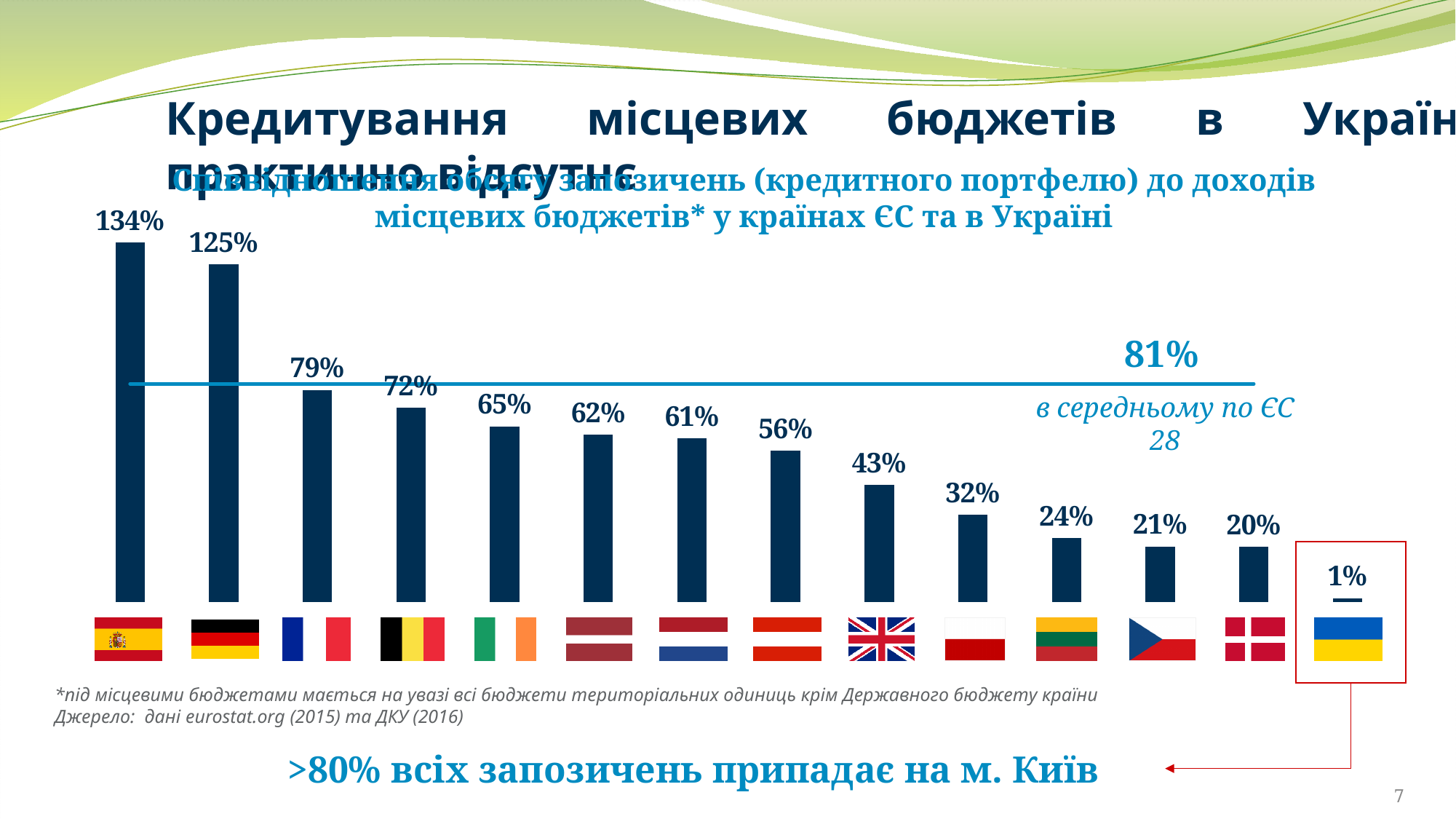
What is the value of the bar marked with the German flag (second from the left)? 125% Which bar has the highest value in the chart? Spain (first bar, 134%) What is the difference between the first bar (134%) and the second bar (125%)? 9% Do the bar values rise or fall from left to right across the chart? fall How many bars (countries) are plotted in the chart? 14 Which is larger: the bar with the French flag or the bar with the Belgian flag? the bar with the French flag (79%) What is the value of the bar marked with the UK flag? 43% What is the value of the bar marked with the Ukrainian flag, highlighted in the red box? 1% What type of chart is shown on the slide? bar chart What value does the horizontal line labelled 'в середньому по ЄС 28' represent? 81% What is the value of the first bar from the left (Spanish flag)? 134% Which bar has the lowest value in the chart? Ukraine (last bar, 1%)